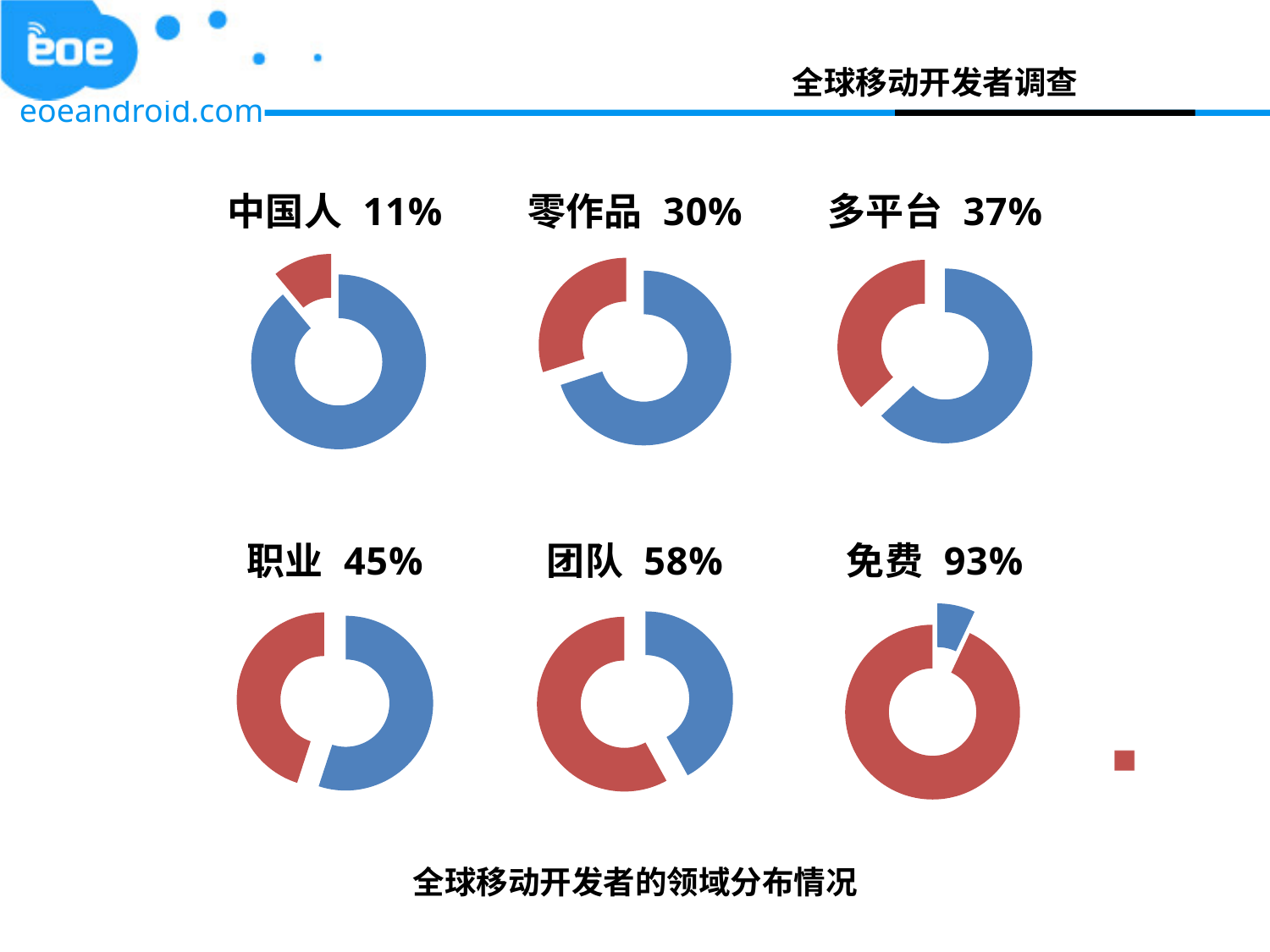
How many donut charts are shown on the slide? 6 In the 职业 chart, what share of the donut does the red slice represent? 45% What kind of chart is used for each of the six figures on the slide? Donut (pie) chart What is the difference between the percentage for 团队 and the percentage for 职业? 13% What percentage is shown for the 多平台 chart? 37% Which of the six charts shows the lowest percentage? 中国人 What colour is the slice representing the labelled percentage in each donut chart? Red What percentage is shown for the 团队 chart? 58% Which of the six charts shows the highest percentage? 免费 Which is larger, the percentage for 零作品 or the percentage for 多平台? 多平台 What percentage is shown for the 免费 chart? 93% What percentage is shown for the 中国人 chart? 11%